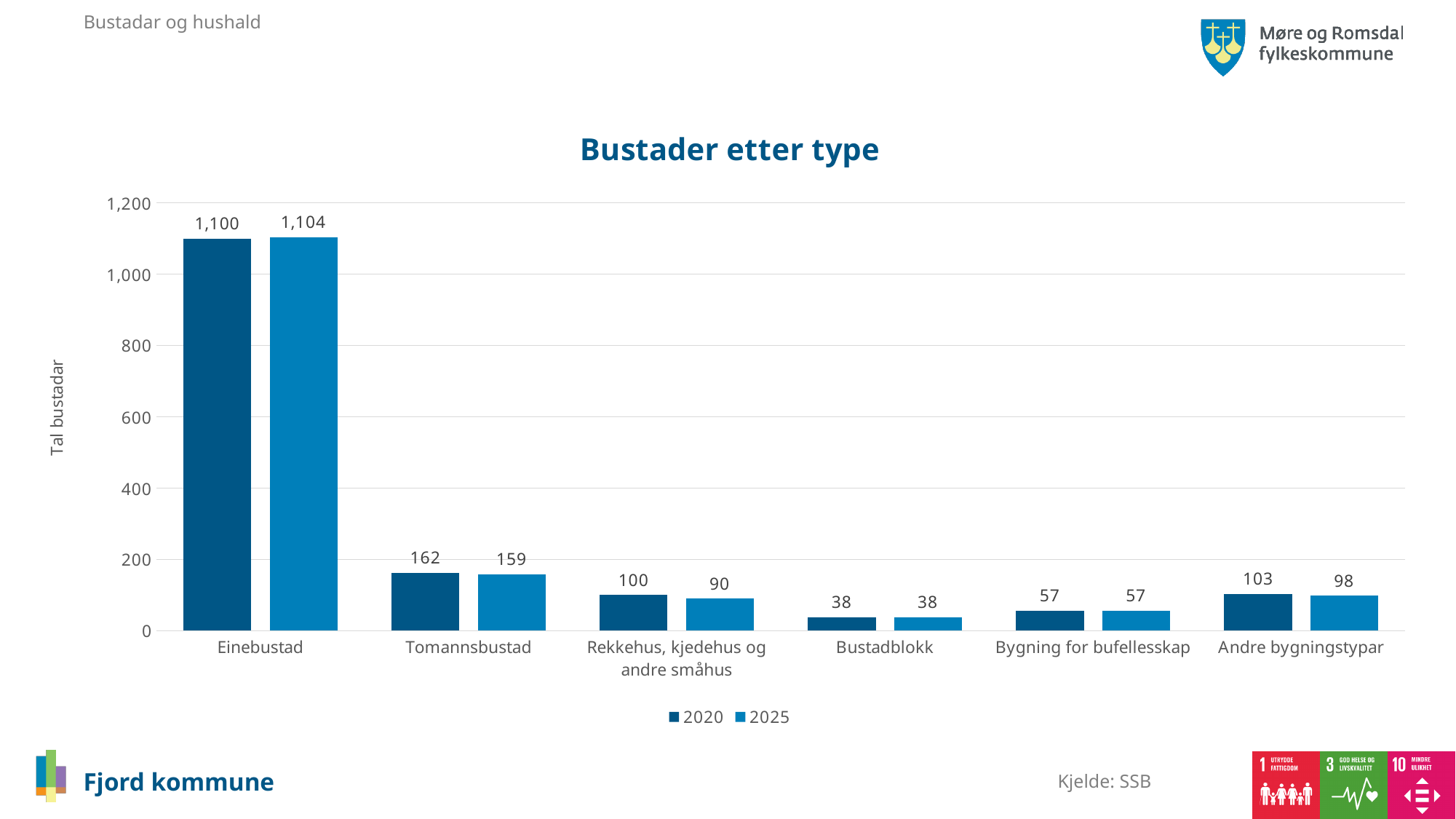
Which is larger for Tomannsbustad: the 2020 value or the 2025 value? 2020 Is the value for Einebustad in 2020 greater or less than 1,000? greater What is the difference between the 2020 and 2025 values for Andre bygningstypar? 5 Which category has the highest value in 2020? Einebustad What is the value for Einebustad in 2025? 1,104 What is the value for Tomannsbustad in 2020? 162 How many series does the legend list? 2 How many categories are shown on the x axis? 6 Which category has the lowest value in 2025? Bustadblokk What is the title of the chart? Bustader etter type What kind of chart is shown? Bar chart What is the value for Rekkehus, kjedehus og andre småhus in 2025? 90